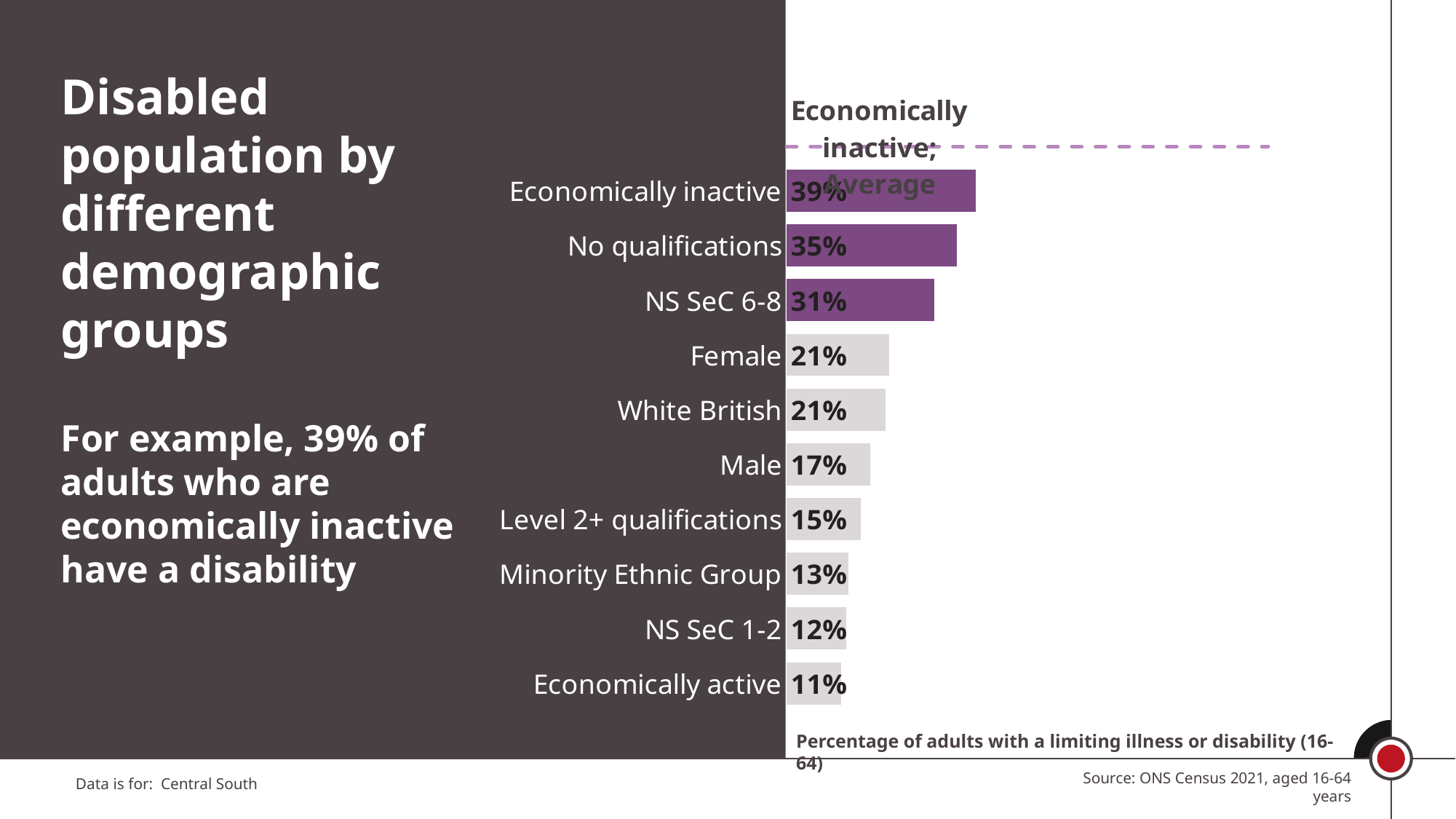
What is the difference between the values for Female and Male? 4% What is the value shown for Minority Ethnic Group? 13% Which is larger, the value for NS SeC 6-8 or the value for NS SeC 1-2? NS SeC 6-8 Which is larger, the value for No qualifications or the value for Level 2+ qualifications? No qualifications Which category has the highest percentage of adults with a limiting illness or disability? Economically inactive What does the dashed line on the chart represent? Economically inactive; Average What percentage of economically inactive adults have a limiting illness or disability? 39% What is the value shown for NS SeC 6-8? 31% Which category has the lowest percentage of adults with a limiting illness or disability? Economically active What kind of chart is shown on the slide? Bar chart How many categories are shown in the chart? 10 What is the difference between the values for Economically inactive and Economically active? 28%